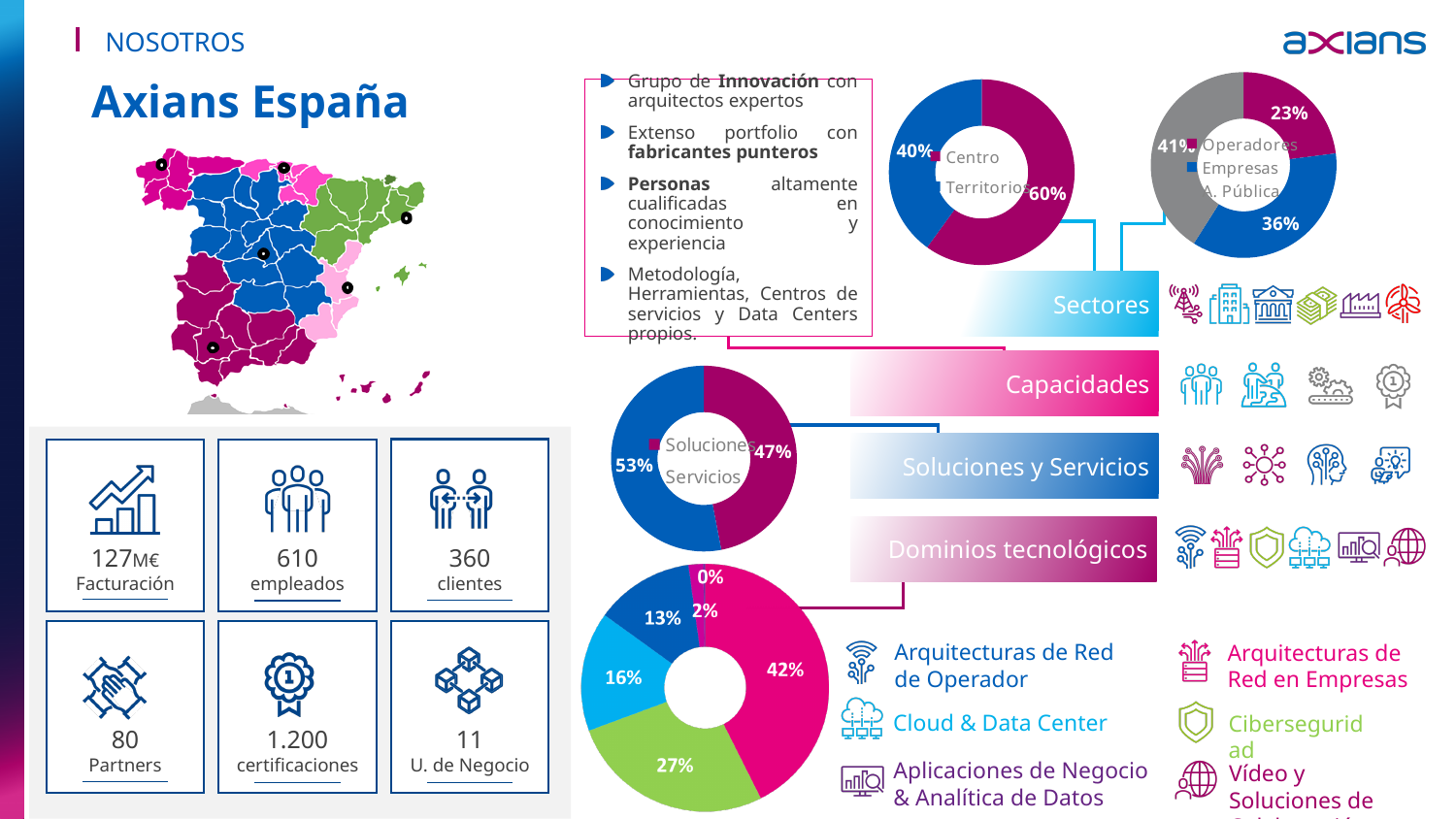
In the middle donut chart (Soluciones / Servicios), what percentage is shown for Servicios? 53% How many categories does the legend of the top-right donut chart (Operadores, Empresas, A. Pública) list? 3 In the top-right donut chart (Operadores, Empresas, A. Pública), which category has the largest share? A. Pública In the middle donut chart (Soluciones / Servicios), which category has the larger share, Soluciones or Servicios? Servicios In the top-right donut chart (Operadores, Empresas, A. Pública), what percentage is shown for A. Pública? 41% In the top-right donut chart (Operadores, Empresas, A. Pública), which category has the smallest share? Operadores In the bottom donut chart (the one with 42%, 27%, 16%, 13%, 2%, 0%), what is the largest percentage shown? 42% In the top-right donut chart (Operadores, Empresas, A. Pública), what percentage is shown for Empresas? 36% In the top-right donut chart (Operadores, Empresas, A. Pública), what percentage is shown for Operadores? 23% In the bottom donut chart (the one with 42%, 27%, 16%, 13%, 2%, 0%), what is the difference between the largest segment (42%) and the second largest (27%)? 15 percentage points What kind of chart is used for the Operadores / Empresas / A. Pública breakdown at the top right of the slide? donut (pie) chart